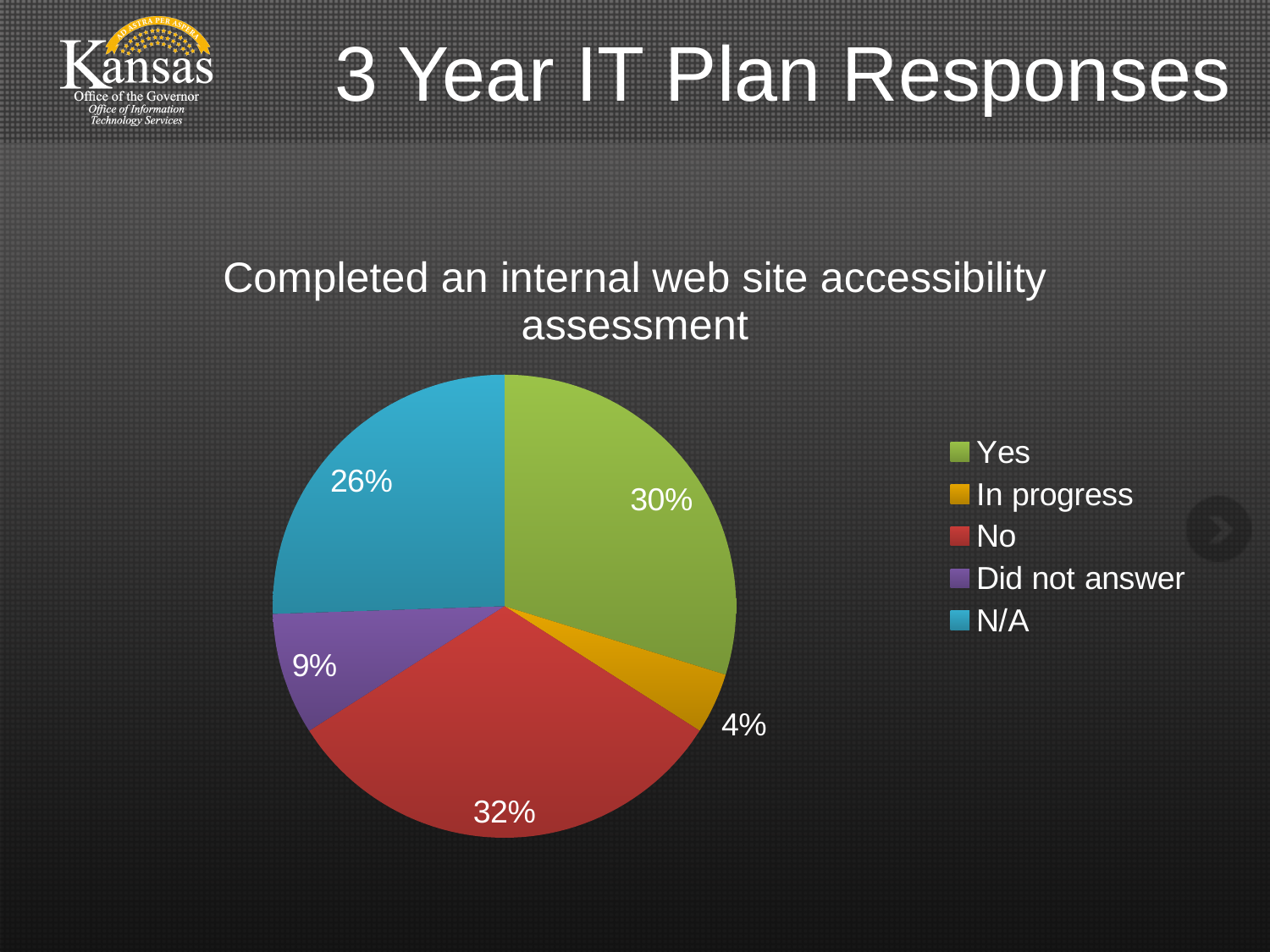
What percentage of responses were "N/A"? 26% Which response category has the largest share of the pie? No What percentage of responses were "No"? 32% What percentage of responses were "Did not answer"? 9% Which is larger, the "Yes" slice or the "N/A" slice? Yes How many categories does the legend list? 5 Which response category has the smallest share of the pie? In progress What type of chart is shown on the slide? Pie chart What percentage of responses were "Yes"? 30% What is the chart's title? Completed an internal web site accessibility assessment What is the difference in percentage points between the "N/A" and "Did not answer" slices? 17 What percentage of responses were "In progress"? 4%